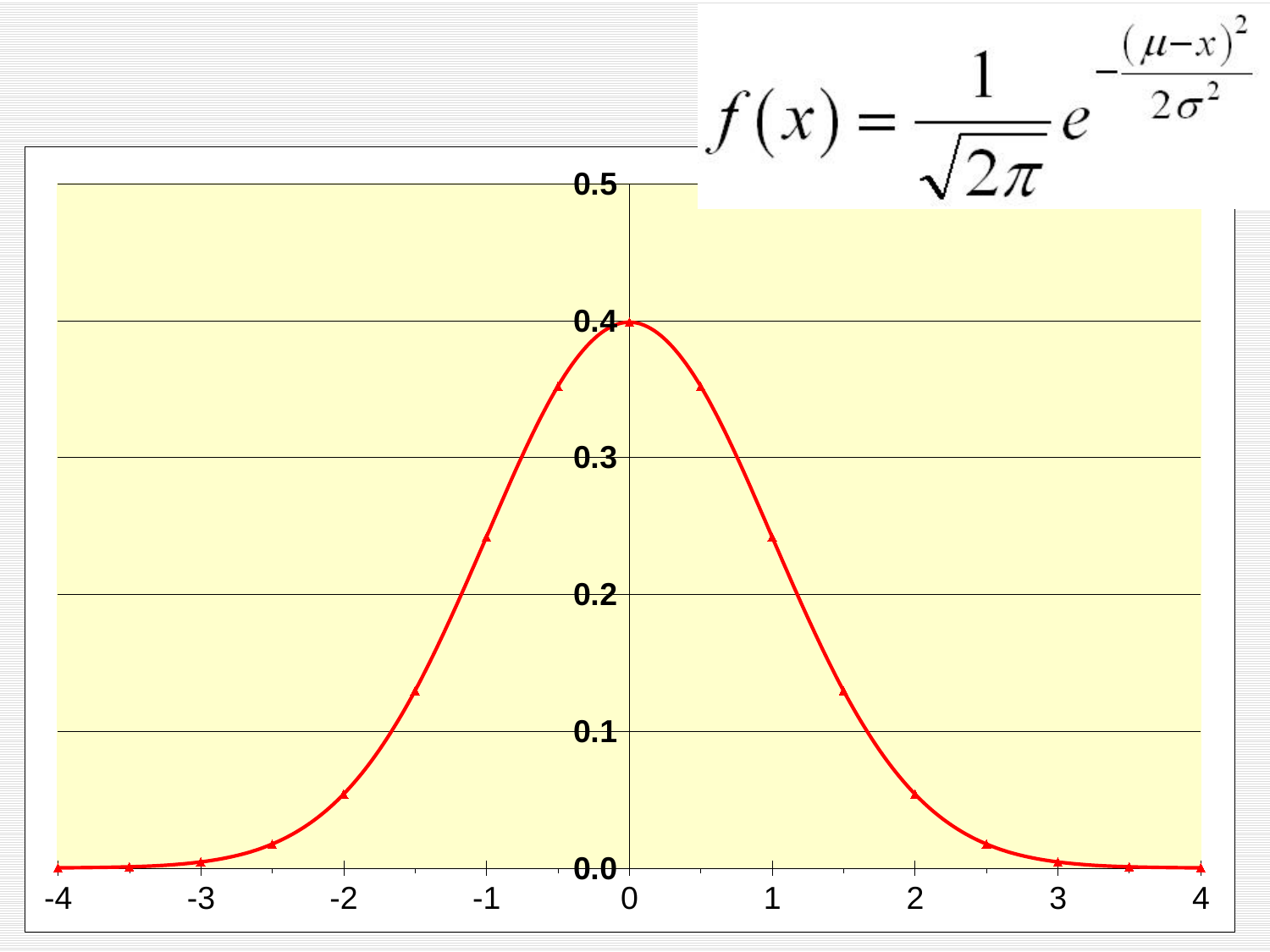
How many data points are plotted on the curve? 17 Is the value at x = 2 greater or less than 0.1? less Is the value at x = 3 greater or less than 0.1? less Is the value at x = 1 greater or less than 0.2? greater Which is larger, the value at x = -1 or the value at x = -2? x = -1 Do the values rise or fall as x goes from 0 to 4? fall Which is larger, the value at x = 0 or the value at x = 2? x = 0 Do the values rise or fall as x goes from -4 to 0? rise What colour is the plotted curve? red At which x value does the curve reach its highest point? 0 What kind of chart is shown on the slide? line chart